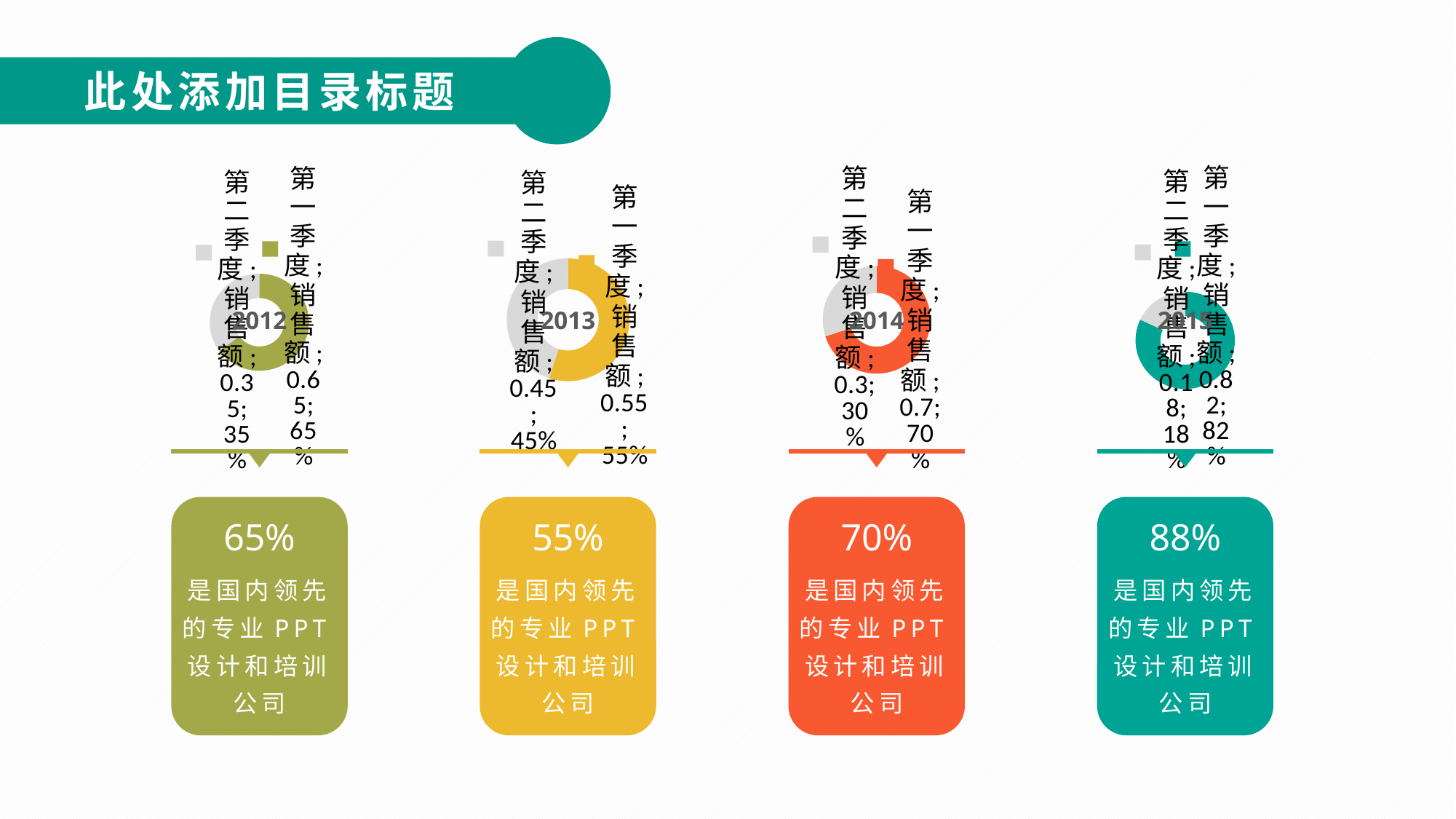
In the 2013 chart, what share does 第一季度销售额 have? 55% How many entries does the legend of the 2014 chart list? 2 In the 2012 chart, what share does 第一季度销售额 have? 65% In the 2015 chart, which slice is larger, 第一季度销售额 or 第二季度销售额? 第一季度销售额 In the 2015 chart, what share does 第二季度销售额 have? 18% What kind of chart is the 2012 chart? Doughnut (pie) chart In the 2014 chart, which slice is the smallest? 第二季度销售额 In the 2013 chart, what is the difference between the 第一季度销售额 and 第二季度销售额 shares? 10% How many slices does the 2015 chart have? 2